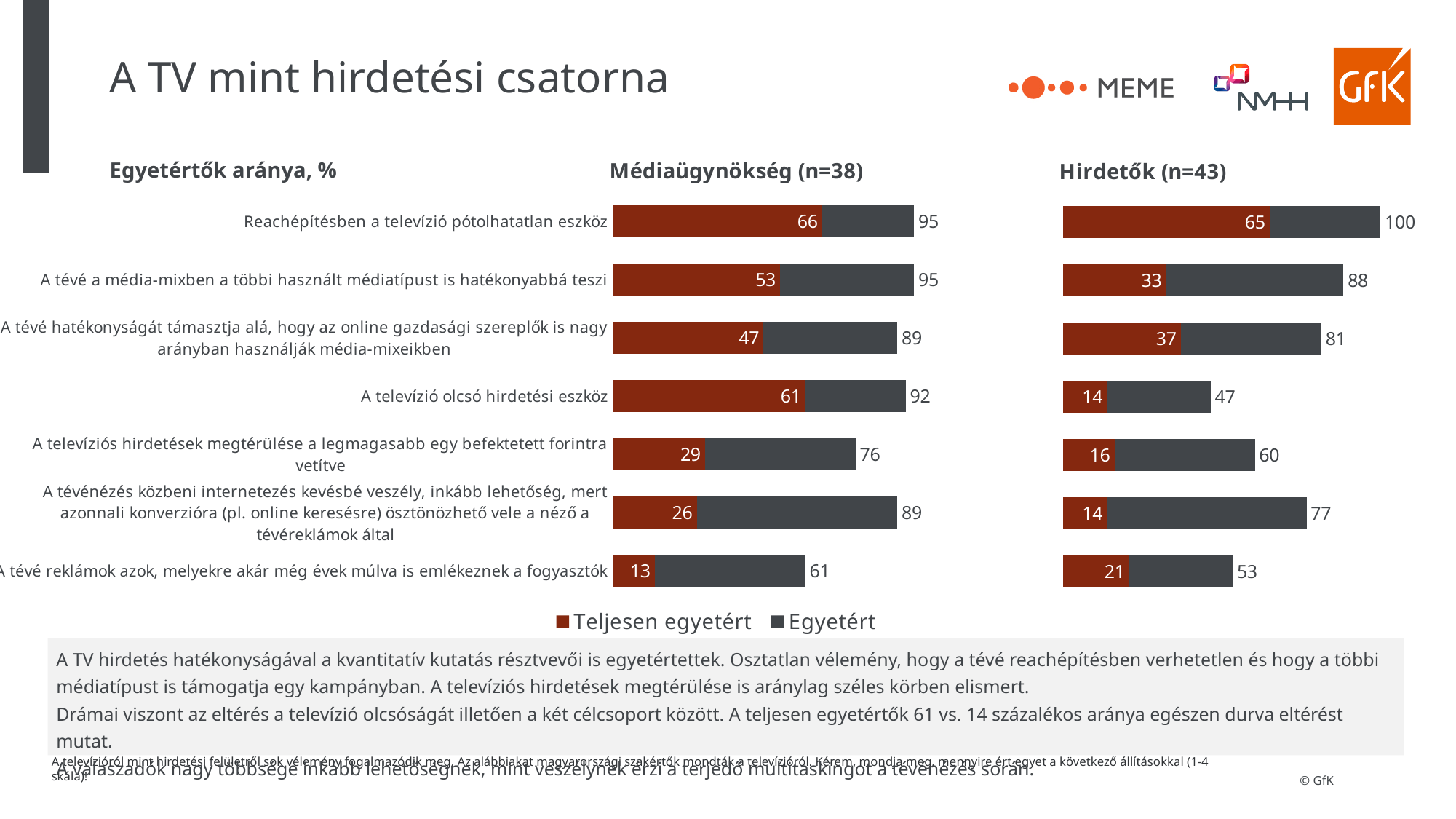
In the Médiaügynökség (n=38) chart, what is the 'Teljesen egyetért' value for 'Reachépítésben a televízió pótolhatatlan eszköz'? 66 In the Médiaügynökség (n=38) chart, what is the difference between the total agreeing shares for 'Reachépítésben a televízió pótolhatatlan eszköz' and 'A tévé reklámok azok, melyekre akár még évek múlva is emlékeznek a fogyasztók'? 34 In the Hirdetők (n=43) chart, which statement has the highest total agreeing share? Reachépítésben a televízió pótolhatatlan eszköz What kind of chart is used for the Hirdetők (n=43) data? Stacked bar chart Which colour represents the 'Teljesen egyetért' series in the legend? Dark red In the Hirdetők (n=43) chart, what is the total agreeing share shown at the end of the bar for 'A televízió olcsó hirdetési eszköz'? 47 What is the difference between the 'Teljesen egyetért' values for 'A televízió olcsó hirdetési eszköz' in the Médiaügynökség chart and in the Hirdetők chart? 47 In the Hirdetők (n=43) chart, what is the 'Teljesen egyetért' value for 'A tévé reklámok azok, melyekre akár még évek múlva is emlékeznek a fogyasztók'? 21 For 'A tévé a média-mixben a többi használt médiatípust is hatékonyabbá teszi', is the total agreeing share larger in the Médiaügynökség chart or in the Hirdetők chart? Médiaügynökség In the Médiaügynökség (n=38) chart, which statement has the lowest 'Teljesen egyetért' value? A tévé reklámok azok, melyekre akár még évek múlva is emlékeznek a fogyasztók How many series does the legend list? 2 How many statements (categories) are shown in the Médiaügynökség (n=38) chart? 7